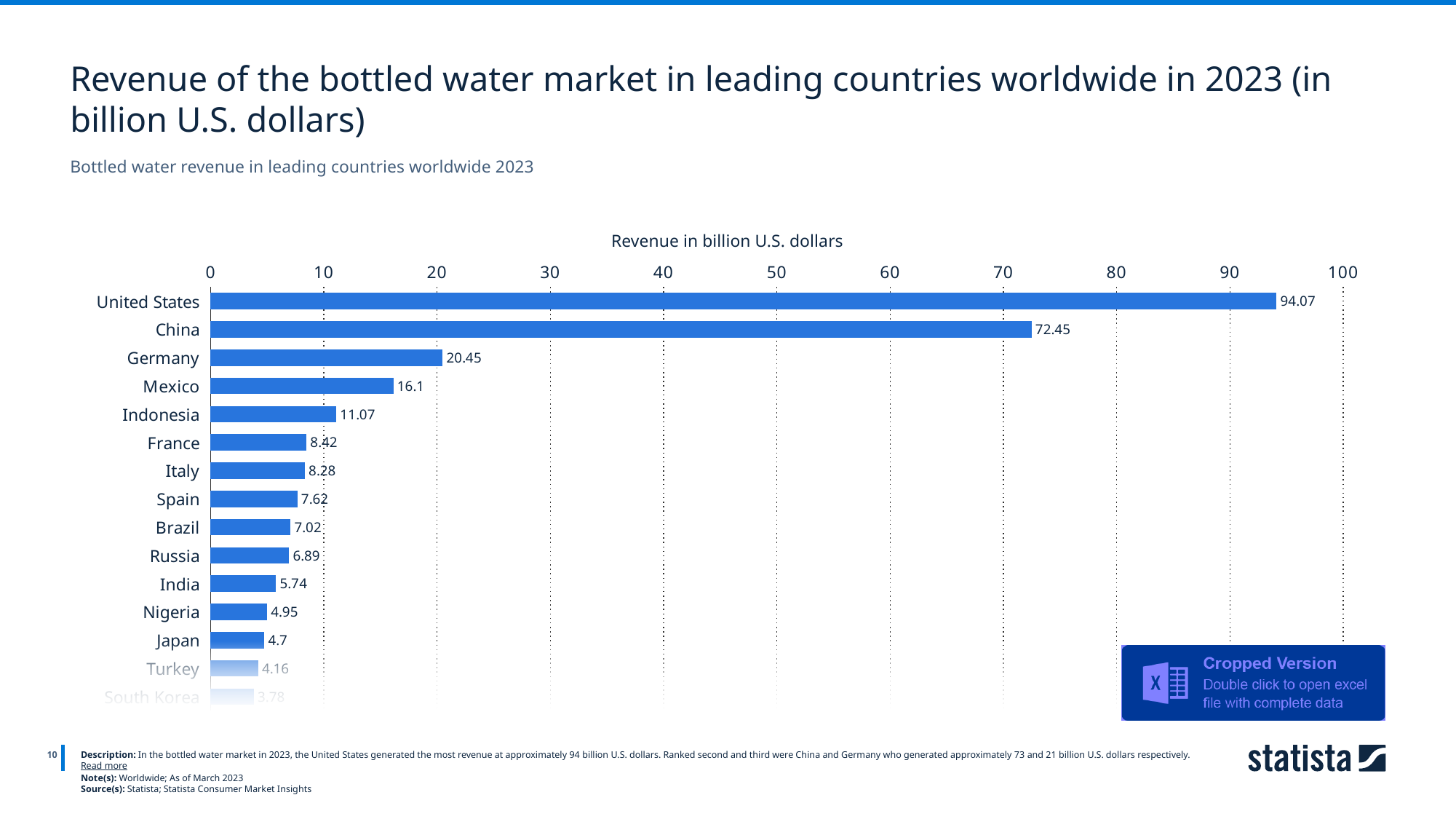
Which has the larger bottled water revenue, Brazil or Russia? Brazil What is the bottled water market revenue for Indonesia? 11.07 What is the label of the horizontal axis of the chart? Revenue in billion U.S. dollars What kind of chart is shown on the slide? Bar chart What is the bottled water market revenue for the United States? 94.07 Is the value for China greater or less than 70? greater What is the difference in revenue between the United States and China? 21.62 Which has the larger bottled water revenue, India or Japan? India What is the bottled water market revenue for Germany? 20.45 What is the bottled water market revenue for Nigeria? 4.95 What is the difference in revenue between Germany and Mexico? 4.35 Which country has the highest bottled water market revenue? United States